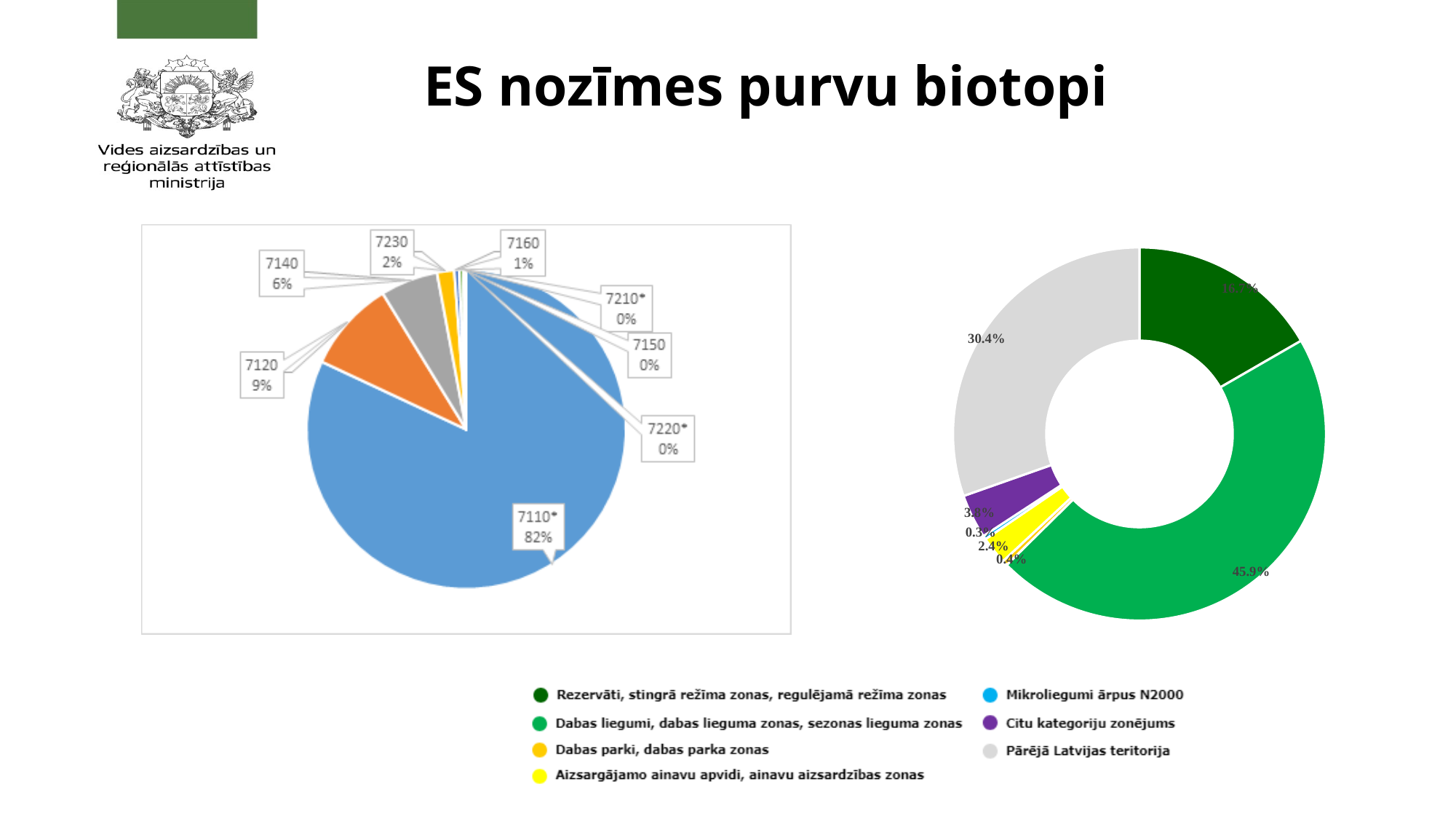
How many entries does the legend of the right donut chart list? 7 In the right donut chart, which category has the largest share? Dabas liegumi, dabas lieguma zonas, sezonas lieguma zonas In the right donut chart, what is the difference between the shares of Dabas liegumi, dabas lieguma zonas, sezonas lieguma zonas and Pārējā Latvijas teritorija? 15.5% In the left pie chart, what percentage is shown for 7110*? 82% What type of chart is the chart on the left of the slide? Pie chart How many categories are labelled in the left pie chart? 8 In the left pie chart, which category has the largest share? 7110* In the left pie chart, what percentage is shown for 7120? 9% In the right donut chart, what percentage is shown for Dabas liegumi, dabas lieguma zonas, sezonas lieguma zonas? 45.9% In the right donut chart, what percentage is shown for Pārējā Latvijas teritorija? 30.4% In the left pie chart, what percentage is shown for 7140? 6% In the left pie chart, what is the difference between the shares of 7120 and 7140? 3%